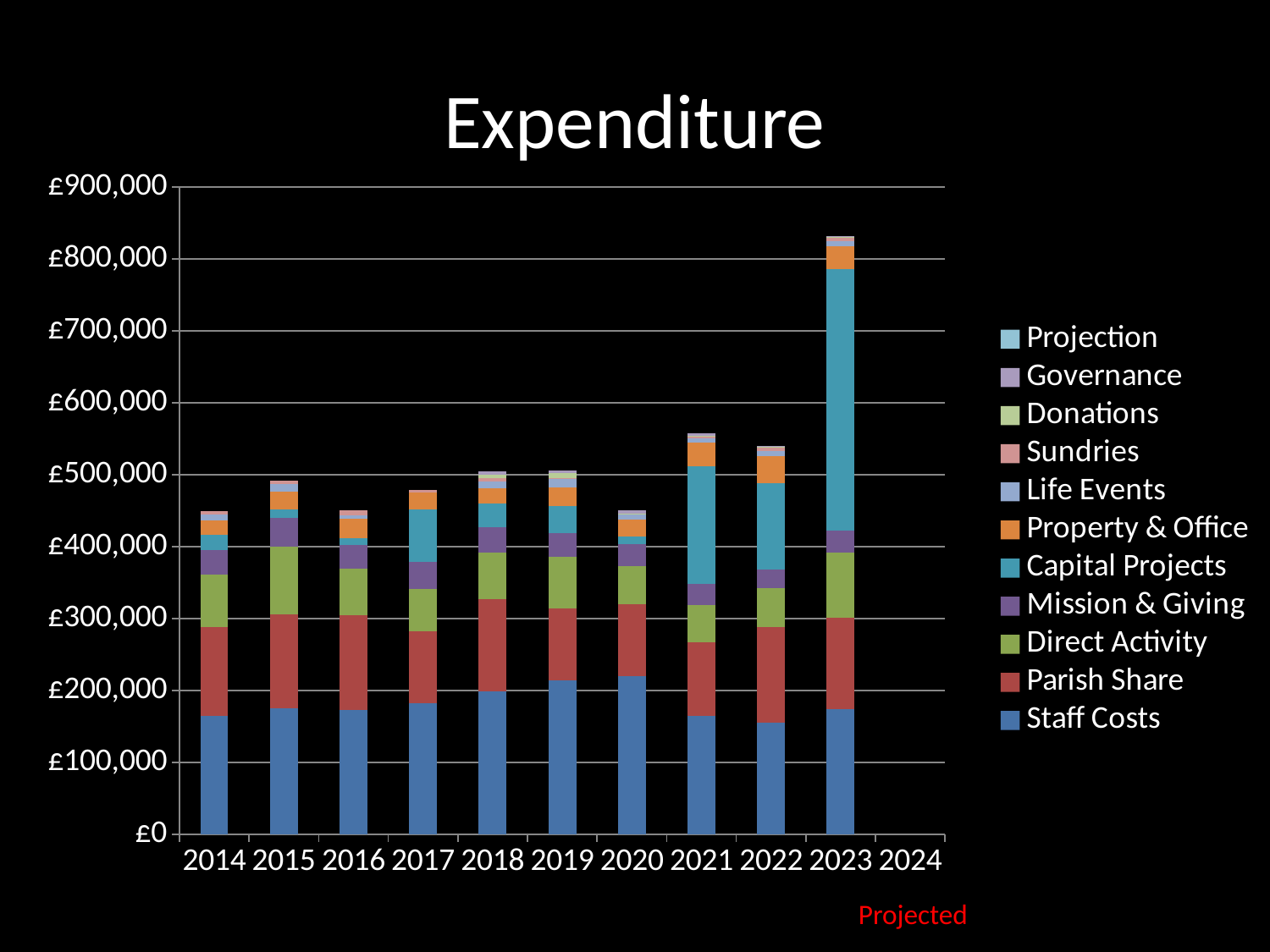
Which year has the larger total expenditure, 2021 or 2023? 2023 Is the total expenditure for 2021 greater or less than £500,000? greater Is the Staff Costs value for 2014 greater or less than £200,000? less Is the total expenditure for 2023 greater or less than £800,000? greater How many year labels appear on the x axis? 11 Which year has the highest total expenditure? 2023 Which series is listed at the bottom of the legend? Staff Costs How many series does the legend list? 11 What is the title of the chart? Expenditure What type of chart is shown on the slide? Stacked bar chart